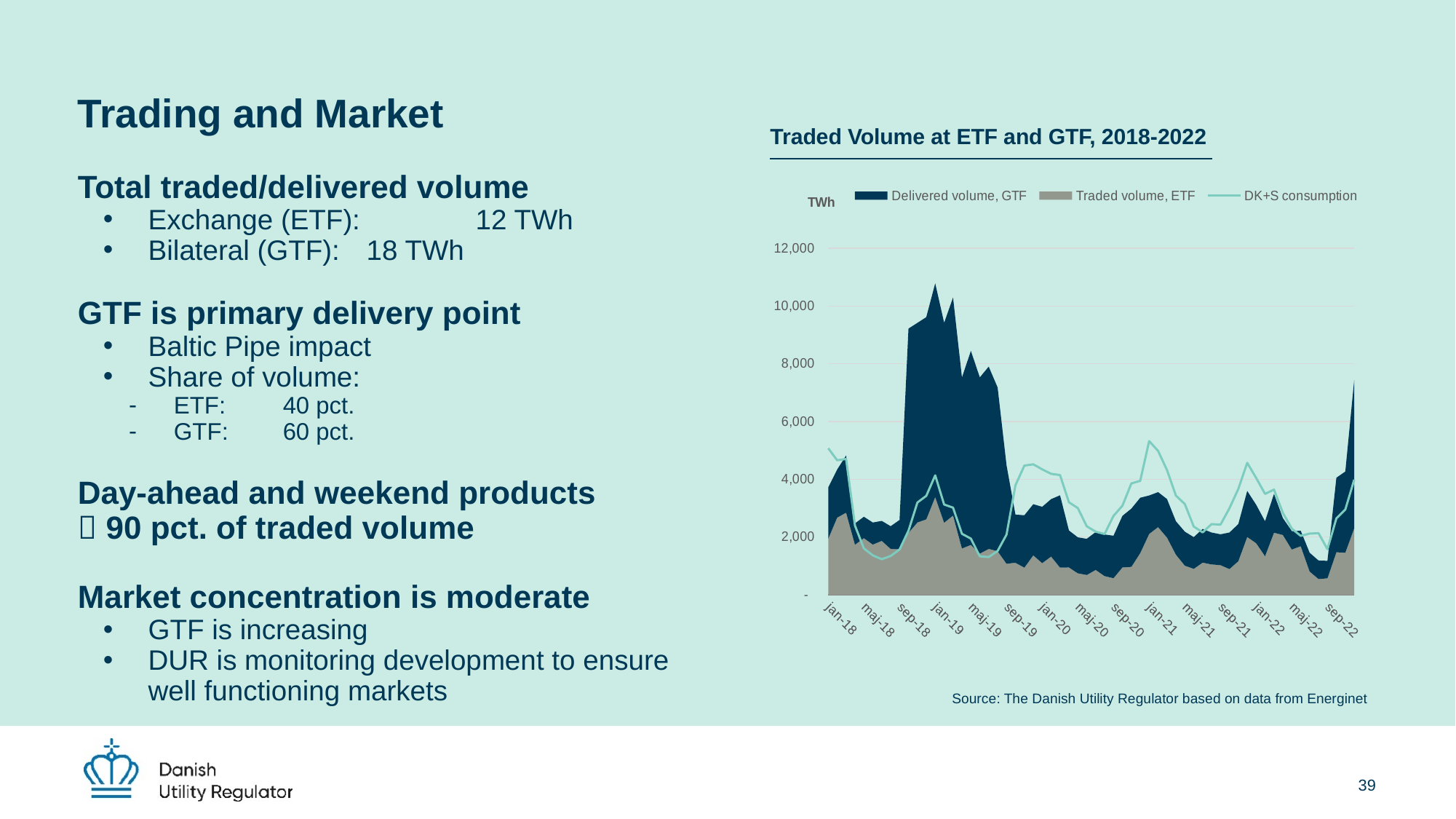
Is the DK+S consumption value at maj-18 greater or less than 2,000? less Does the DK+S consumption line rise or fall between jan-18 and maj-18? fall Around which x-axis label does the stacked total (GTF plus ETF) reach its highest point? jan-19 What unit is shown on the chart's vertical axis? TWh Which is larger at jan-19: the stacked total (GTF plus ETF) or the DK+S consumption? the stacked total (GTF plus ETF) Is the DK+S consumption value at jan-18 greater or less than 4,000? greater What kind of chart is shown on the slide? area and line chart Is the stacked total (GTF plus ETF) at sep-22 greater or less than 6,000? less What is the title of the chart? Traded Volume at ETF and GTF, 2018-2022 How many series does the chart legend list? 3 How many labels are shown on the chart's x axis? 15